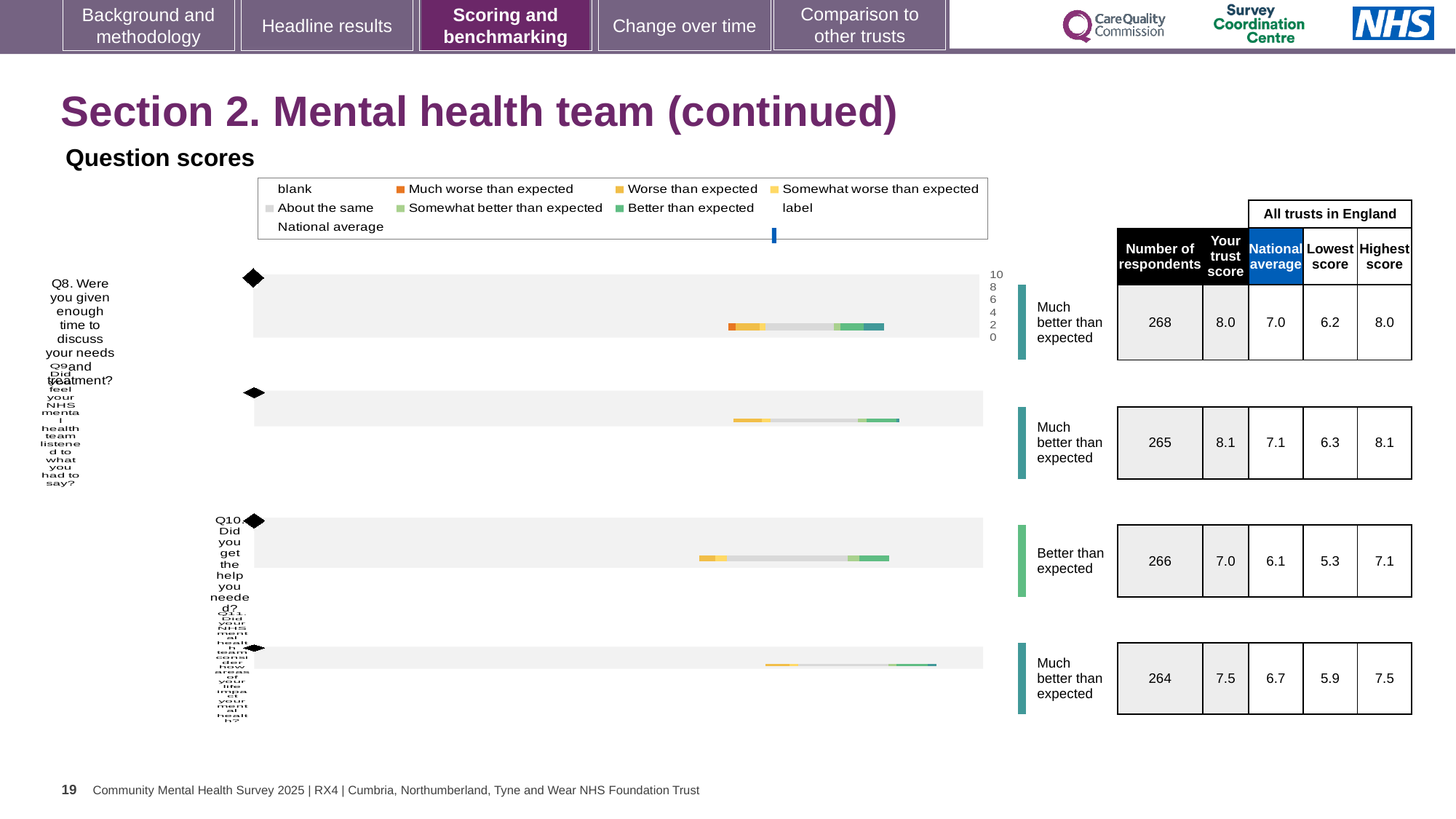
For Q11, what is the lowest score among all trusts in England? 5.9 What is the highest tick value shown on the axis of the Q8 chart? 10 How many question charts (Q8 to Q11) are shown on the slide? 4 What kind of chart is used for the Q8 question score? bar chart Which colour in the legend represents 'Much worse than expected'? orange Which question has the fewest respondents on this slide? Q11 For Q8 (Were you given enough time to discuss your needs and treatment?), what is the trust score? 8.0 What is the benchmark category shown for Q10? Better than expected What is the difference between the trust score and the national average for Q8? 1.0 For Q10 (Did you get the help you needed?), how many respondents are there? 266 For Q9 (Did you feel your NHS mental health team listened to what you had to say?), what is the national average? 7.1 Which question has the highest trust score on this slide? Q9